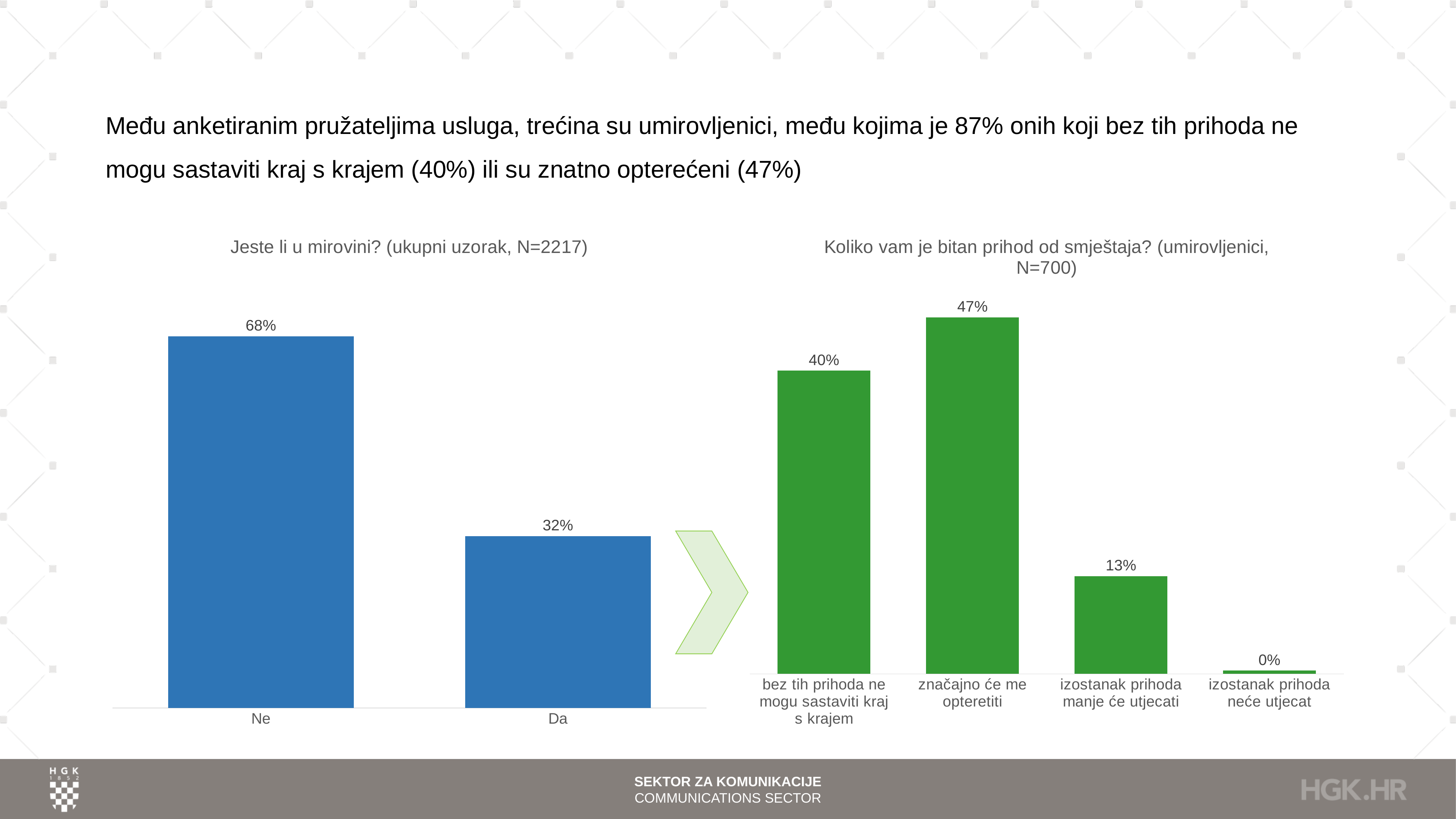
In the chart titled "Koliko vam je bitan prihod od smještaja? (umirovljenici, N=700)", which category has the lowest value? izostanak prihoda neće utjecat In the chart titled "Jeste li u mirovini? (ukupni uzorak, N=2217)", what is the value for "Da"? 32% In the chart titled "Jeste li u mirovini? (ukupni uzorak, N=2217)", what is the value for "Ne"? 68% In the chart titled "Koliko vam je bitan prihod od smještaja? (umirovljenici, N=700)", what is the value for "značajno će me opteretiti"? 47% In the chart titled "Koliko vam je bitan prihod od smještaja? (umirovljenici, N=700)", which is larger: the value for "bez tih prihoda ne mogu sastaviti kraj s krajem" or for "izostanak prihoda manje će utjecati"? bez tih prihoda ne mogu sastaviti kraj s krajem In the chart titled "Jeste li u mirovini? (ukupni uzorak, N=2217)", how many categories are shown? 2 In the chart titled "Jeste li u mirovini? (ukupni uzorak, N=2217)", what is the difference between the values for "Ne" and "Da"? 36% In the chart titled "Koliko vam je bitan prihod od smještaja? (umirovljenici, N=700)", what is the value for "izostanak prihoda manje će utjecati"? 13% In the chart titled "Koliko vam je bitan prihod od smještaja? (umirovljenici, N=700)", how many categories are shown? 4 What kind of chart is the chart titled "Jeste li u mirovini? (ukupni uzorak, N=2217)"? bar chart In the chart titled "Koliko vam je bitan prihod od smještaja? (umirovljenici, N=700)", which category has the highest value? značajno će me opteretiti In the chart titled "Koliko vam je bitan prihod od smještaja? (umirovljenici, N=700)", what is the difference between the values for "značajno će me opteretiti" and "bez tih prihoda ne mogu sastaviti kraj s krajem"? 7%